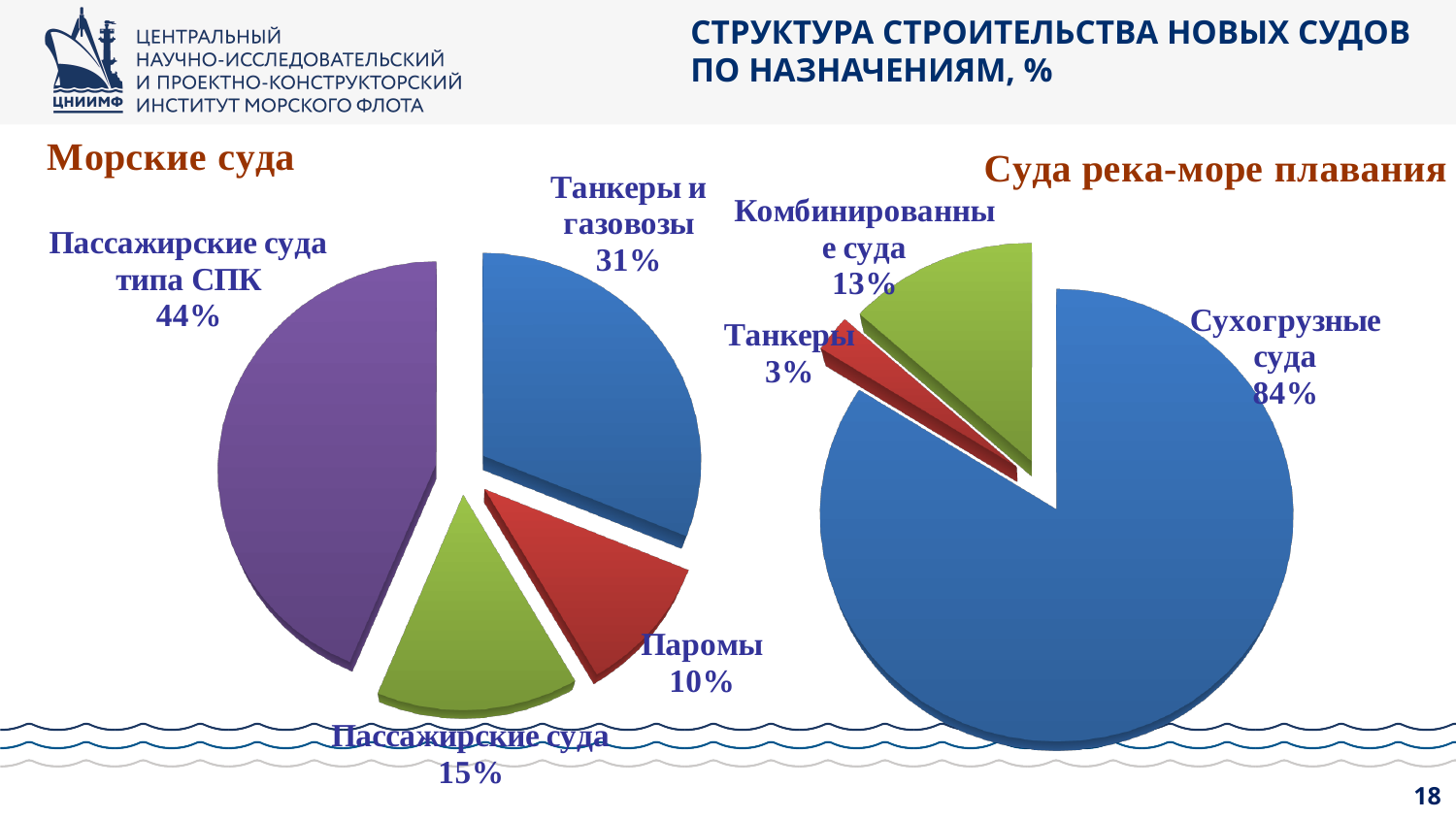
На диаграмме «Морские суда» какова доля паромов? 10% На диаграмме «Морские суда» какова доля пассажирских судов типа СПК? 44% На диаграмме «Морские суда» какова доля танкеров и газовозов? 31% На диаграмме «Морские суда» на сколько процентных пунктов доля танкеров и газовозов больше доли пассажирских судов? 16 На диаграмме «Морские суда» какая категория имеет наименьшую долю? Паромы На диаграмме «Морские суда» какая категория имеет наибольшую долю? Пассажирские суда типа СПК На диаграмме «Суда река-море плавания» какова доля танкеров? 3% Сколько категорий показано на диаграмме «Морские суда»? 4 На диаграмме «Суда река-море плавания» что больше: доля комбинированных судов или доля танкеров? Комбинированные суда Сколько категорий показано на диаграмме «Суда река-море плавания»? 3 На диаграмме «Суда река-море плавания» какова доля сухогрузных судов? 84% Какой тип диаграммы используется на слайде для «Морские суда»? Круговая диаграмма